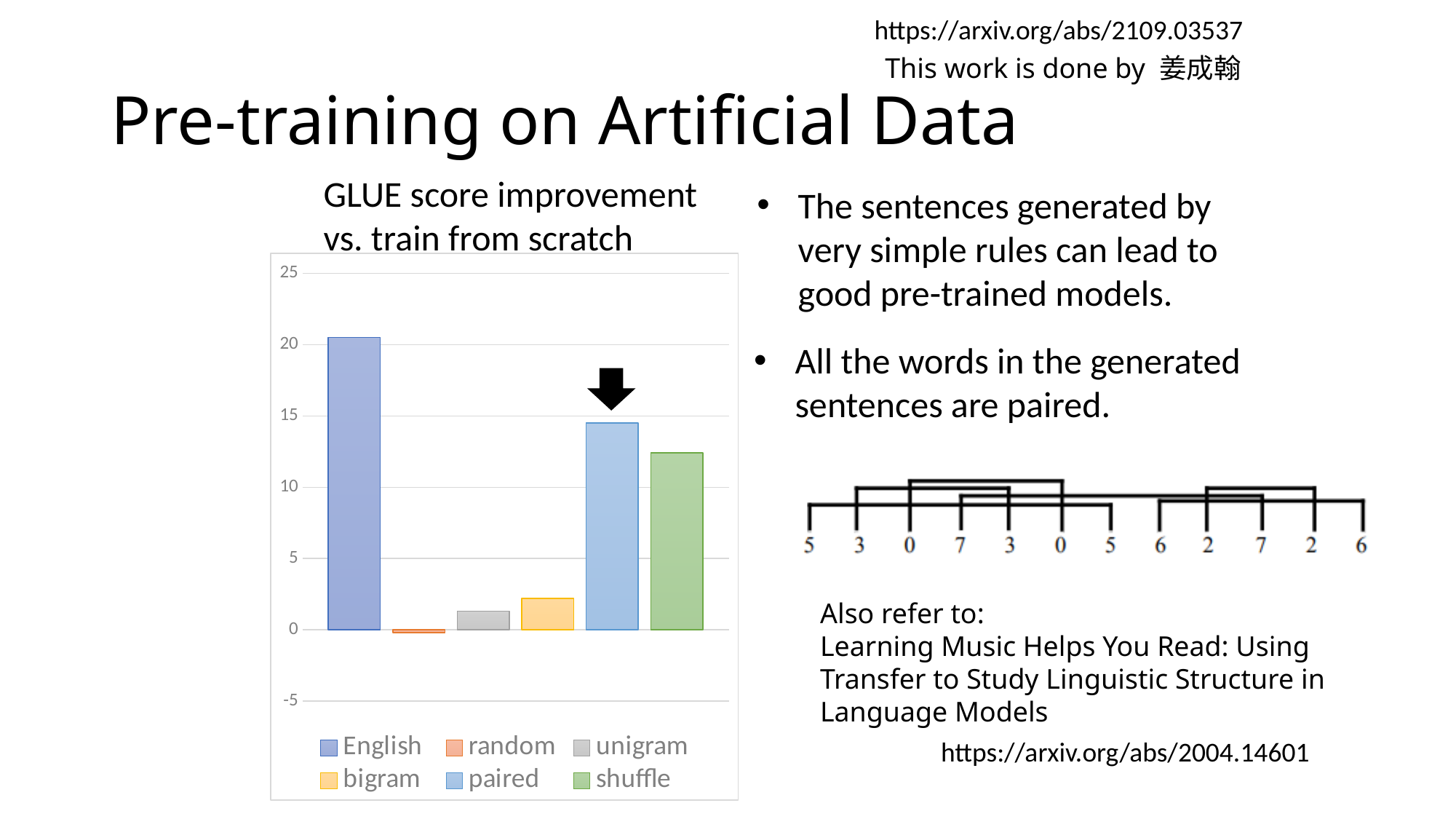
Is the value for English greater or less than 15? greater What kind of chart is shown on the slide? bar chart How many series does the legend list? 6 Which series has the highest GLUE score improvement in the chart? English Which has a larger GLUE score improvement, unigram or bigram? bigram Is the value for shuffle greater or less than 10? greater What is the title of the chart? GLUE score improvement vs. train from scratch Is the value for paired greater or less than 10? greater Which series has the lowest GLUE score improvement in the chart? random Which has a larger GLUE score improvement, paired or shuffle? paired Which series' bar has a black arrow pointing down at it? paired